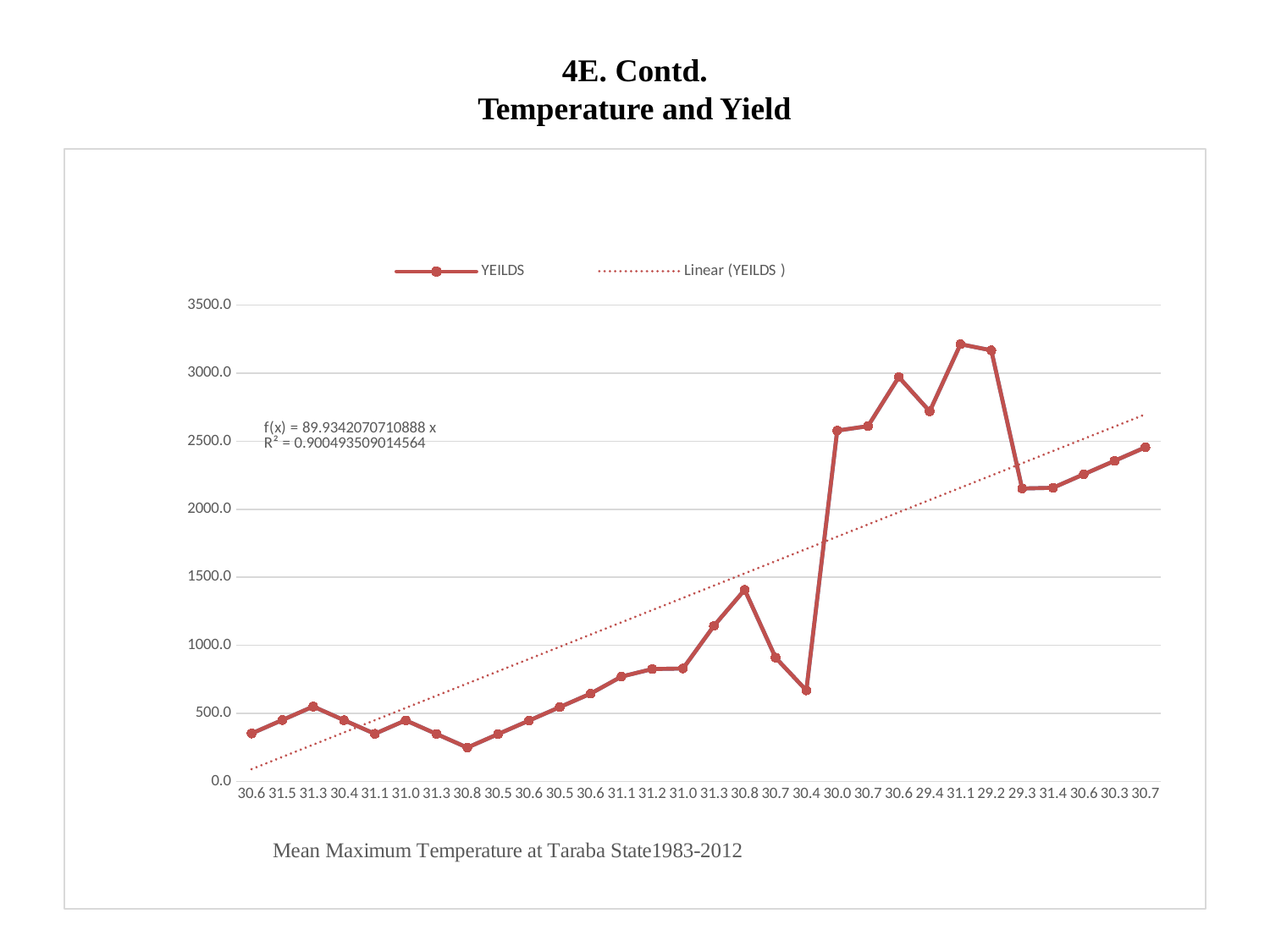
What is the x-axis label of the lowest point on the YEILDS line? 30.8 What R² value is printed on the chart? 0.900493509014564 What kind of chart is shown on the slide? line chart Is the YEILDS value for the first point (x label 30.6) greater or less than 500? less Is the YEILDS value for the last point (x label 30.7) greater or less than 2000? greater How many series does the legend list? 2 Do the YEILDS values generally rise or fall from left to right along the x axis? rise Which is larger: the YEILDS value at the x label 29.4 or the YEILDS value at the x label 29.3? 29.4 How many data points are plotted on the YEILDS line? 30 Is the YEILDS value at the x label 29.2 greater or less than 3000? greater What are the two entries in the chart legend? YEILDS and Linear (YEILDS ) What is the x-axis label of the highest point on the YEILDS line? 31.1